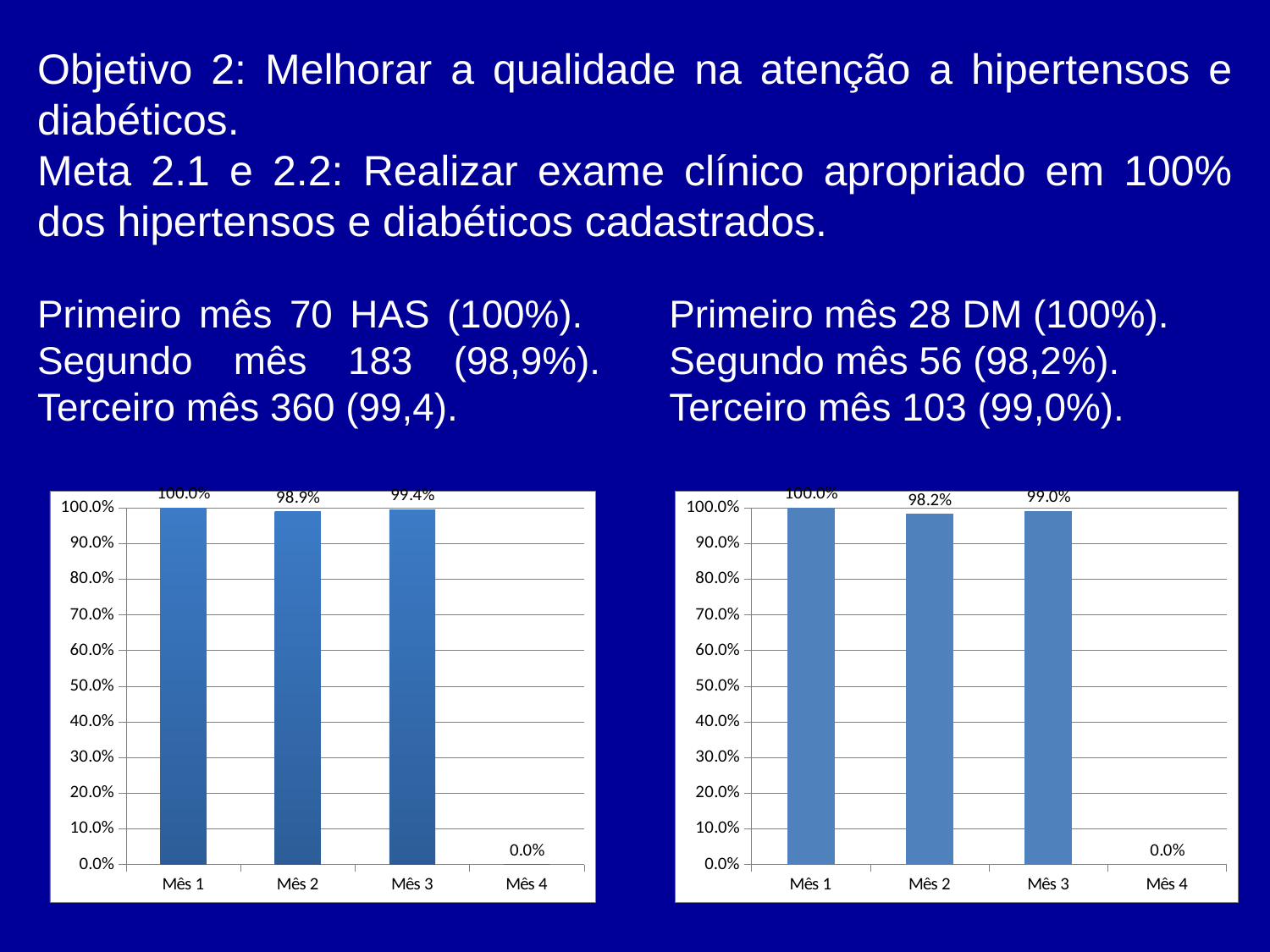
In the left chart, which category has the lowest value? Mês 4 In the right chart, what is the value for Mês 3? 99.0% In the right chart, which category has the highest value? Mês 1 In the left chart, what is the value for Mês 4? 0.0% How many categories are shown on the x axis of the right chart? 4 What kind of chart is the left chart? bar chart In the left chart, is the value for Mês 3 greater or less than 90.0%? greater In the left chart, what is the difference between the values for Mês 1 and Mês 2? 1.1% In the right chart, which is larger, the value for Mês 2 or the value for Mês 3? Mês 3 In the right chart, what is the value for Mês 1? 100.0% In the left chart, what is the value for Mês 2? 98.9% In the right chart, what is the difference between the values for Mês 3 and Mês 2? 0.8%